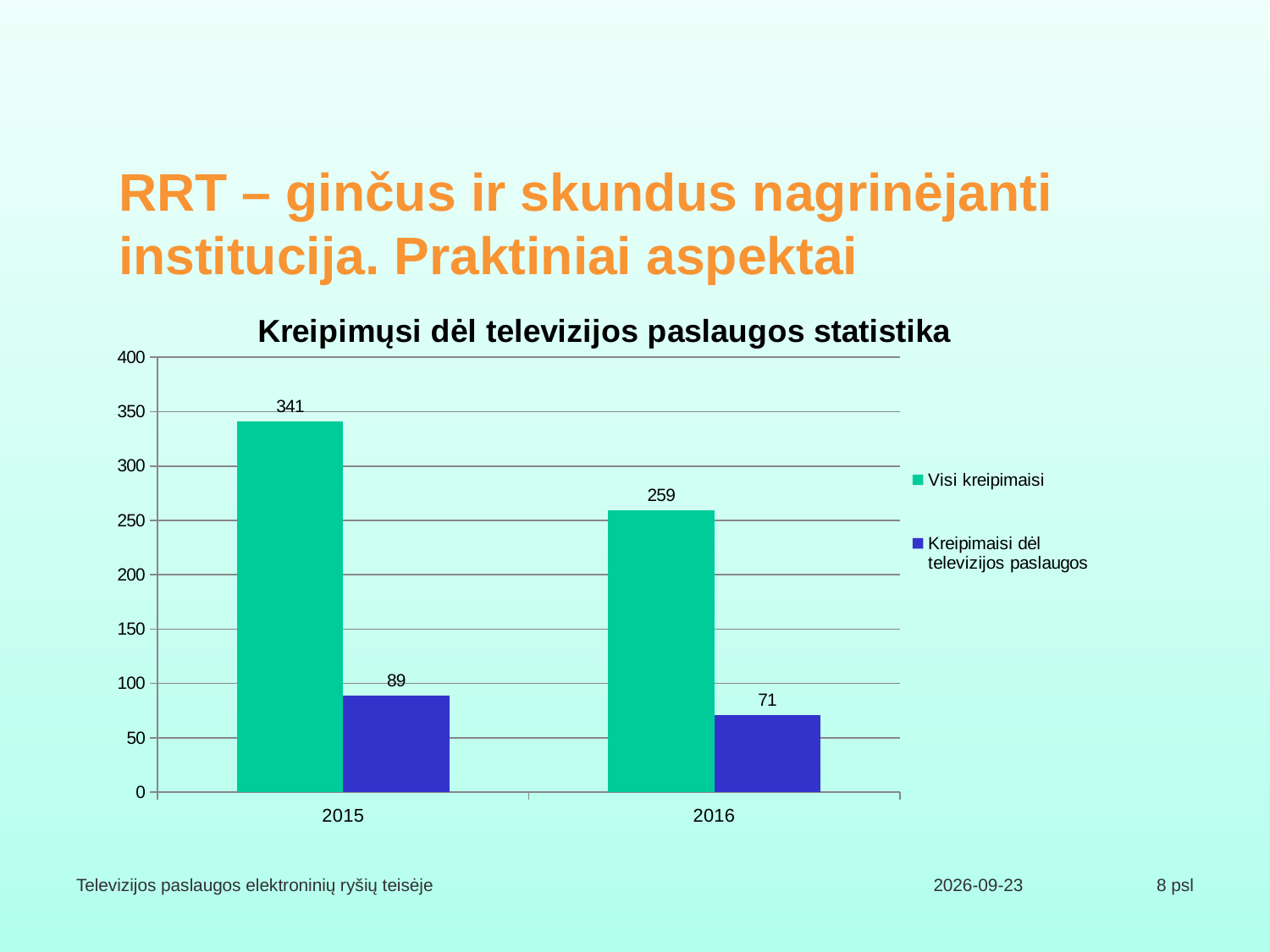
How many series does the legend list? 2 Is the value for Visi kreipimaisi in 2016 greater or less than 250? greater Which year has the lower value for Kreipimaisi dėl televizijos paslaugos? 2016 What is the difference between Visi kreipimaisi in 2015 and 2016? 82 What is the difference between Visi kreipimaisi and Kreipimaisi dėl televizijos paslaugos in 2016? 188 What is the value of Kreipimaisi dėl televizijos paslaugos for 2015? 89 What is the title of the chart? Kreipimųsi dėl televizijos paslaugos statistika What is the value of Visi kreipimaisi for 2016? 259 Which year has the higher value for Visi kreipimaisi? 2015 What is the value of Kreipimaisi dėl televizijos paslaugos for 2016? 71 What is the value of Visi kreipimaisi for 2015? 341 What kind of chart is shown on the slide? Bar chart